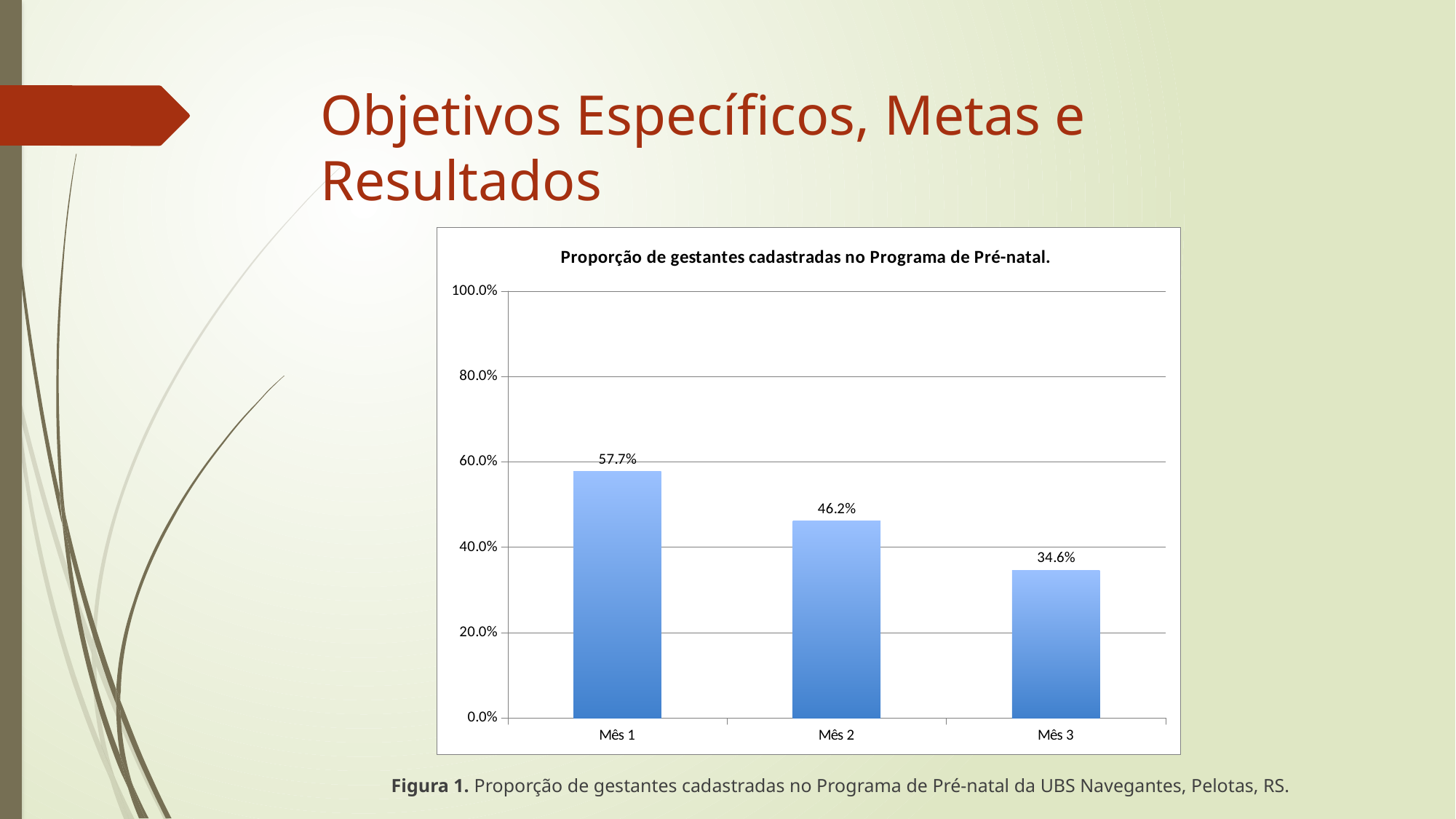
Do the values rise or fall from Mês 1 to Mês 3? fall How many months are shown on the x axis? 3 What is the difference between the values for Mês 1 and Mês 3? 23.1% What is the value for Mês 2? 46.2% Which month has the lowest proportion? Mês 3 What is the value for Mês 1? 57.7% What kind of chart is shown on the slide? bar chart What is the value for Mês 3? 34.6% Is the value for Mês 3 greater or less than 40.0%? less Which is larger, the value for Mês 2 or the value for Mês 3? Mês 2 What is the difference between the values for Mês 1 and Mês 2? 11.5% Which month has the highest proportion? Mês 1